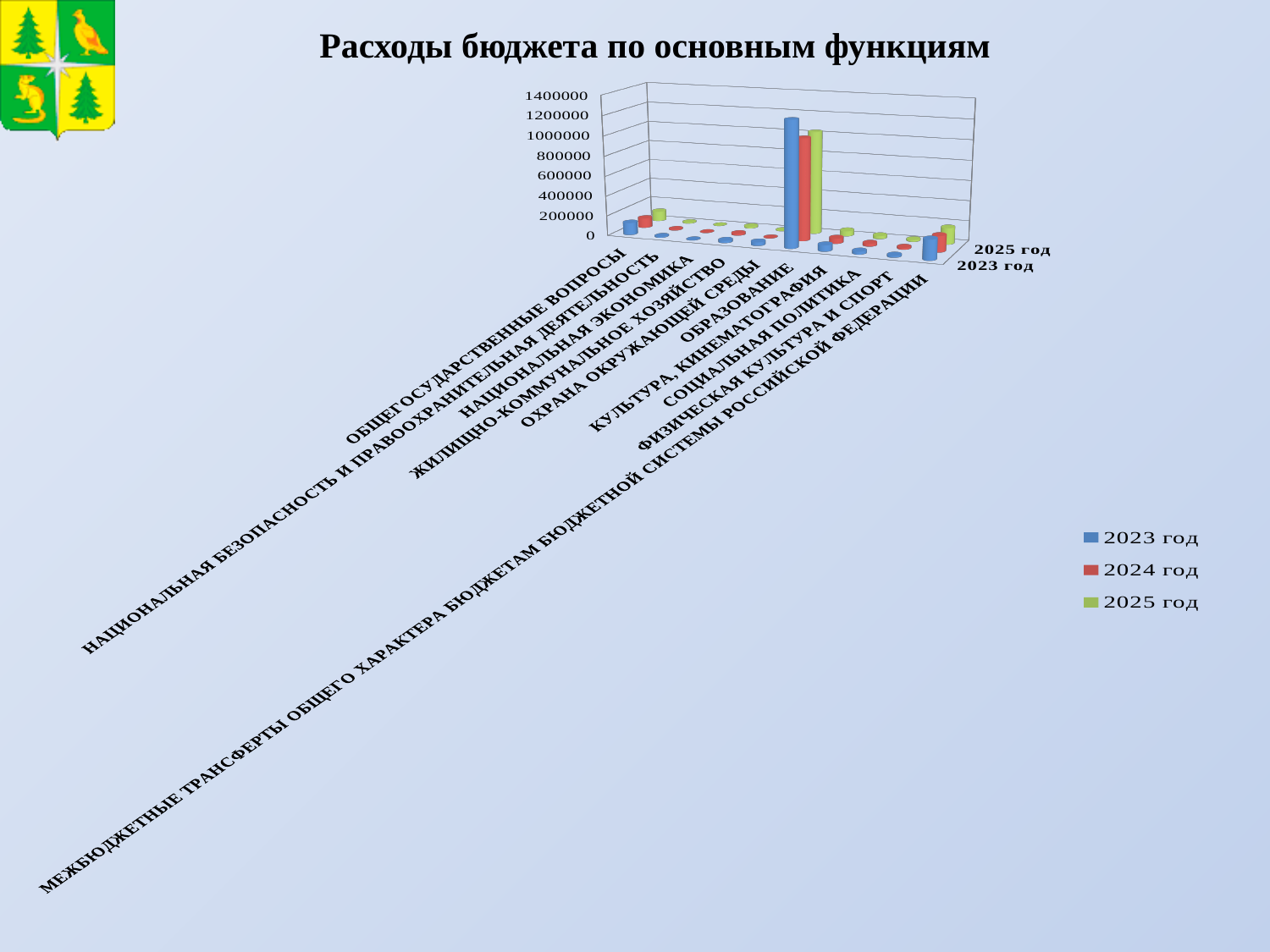
Which is larger for 2025 год: ОБРАЗОВАНИЕ or ЖИЛИЩНО-КОММУНАЛЬНОЕ ХОЗЯЙСТВО? ОБРАЗОВАНИЕ Which is larger for 2024 год: ОБРАЗОВАНИЕ or СОЦИАЛЬНАЯ ПОЛИТИКА? ОБРАЗОВАНИЕ Which series are listed in the legend? 2023 год, 2024 год, 2025 год Is the 2025 год value for ОХРАНА ОКРУЖАЮЩЕЙ СРЕДЫ greater or less than 200000? less How many series does the legend list? 3 What is the title of the chart? Расходы бюджета по основным функциям How many categories are shown on the category axis? 10 Which category has the highest values across all three years? ОБРАЗОВАНИЕ What kind of chart is shown on the slide? bar chart What is the highest value shown on the vertical axis? 1400000 Is the 2023 год value for ОБРАЗОВАНИЕ greater or less than 800000? greater Is the 2023 год value for ОБЩЕГОСУДАРСТВЕННЫЕ ВОПРОСЫ greater or less than 400000? less